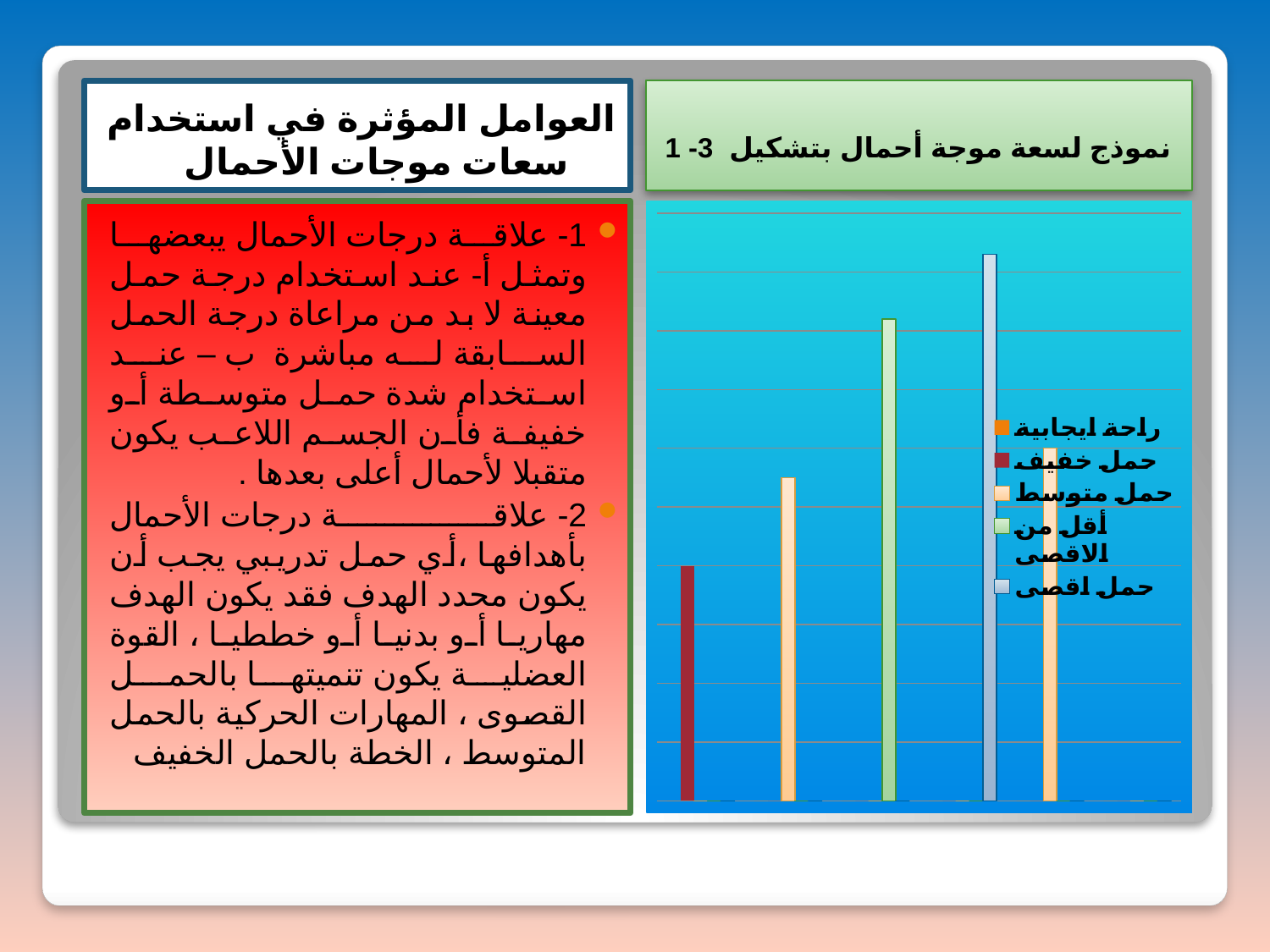
Which bar is taller: the one for أقل من الاقصى or the one for حمل متوسط? أقل من الاقصى What colour is the legend marker for حمل اقصى? light blue What kind of chart is shown on the slide? bar chart Which legend series has the shortest visible bar in the chart? حمل خفيف What is the title shown above the chart? نموذج لسعة موجة أحمال بتشكيل 3-1 Which legend series has the tallest bar in the chart? حمل اقصى Do the bar heights rise or fall from the first bar to the fourth bar along the x axis? rise Does the last bar in the chart rise or fall compared with the bar immediately before it? fall Which bar is taller: the one for حمل خفيف or the one for حمل متوسط? حمل متوسط How many entries does the chart's legend list? 5 How many bars are visible in the chart? 5